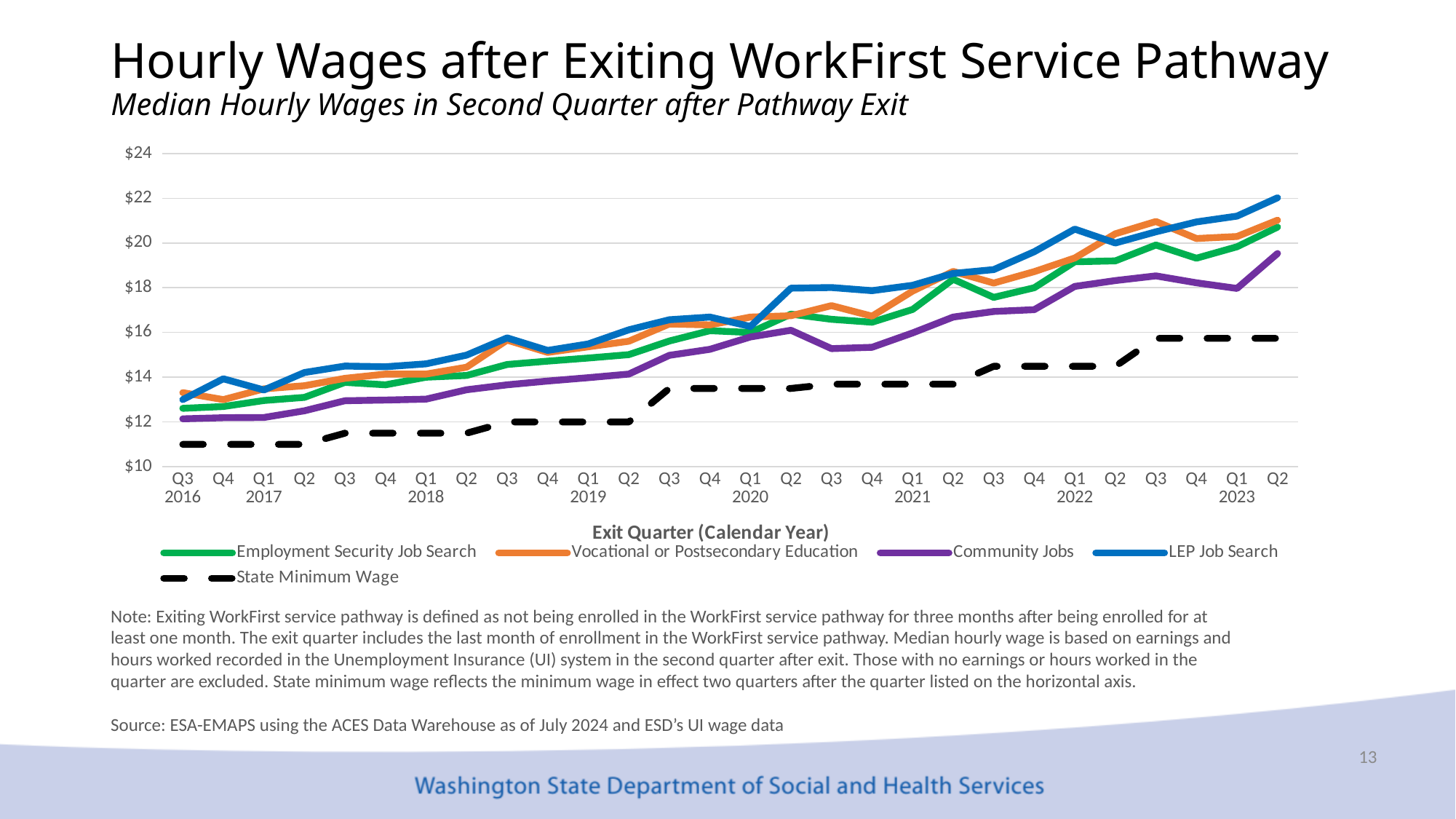
At Q2 2023, which is higher: LEP Job Search or Community Jobs? LEP Job Search How many series does the legend list? 5 How many exit quarters are plotted along the x axis? 28 What kind of chart is shown on the slide? Line chart Which series is shown with a dashed black line? State Minimum Wage What is the title of the horizontal axis? Exit Quarter (Calendar Year) Which series has the highest median hourly wage at Q2 2023? LEP Job Search Is the value for State Minimum Wage at Q3 2016 greater or less than $12? less Among the four pathway series, which has the lowest median hourly wage at Q2 2023? Community Jobs Which series has the lowest value at Q2 2023? State Minimum Wage Is the value for Community Jobs at Q2 2023 greater or less than $18? greater Do the median hourly wages for LEP Job Search generally rise or fall from Q3 2016 to Q2 2023? Rise